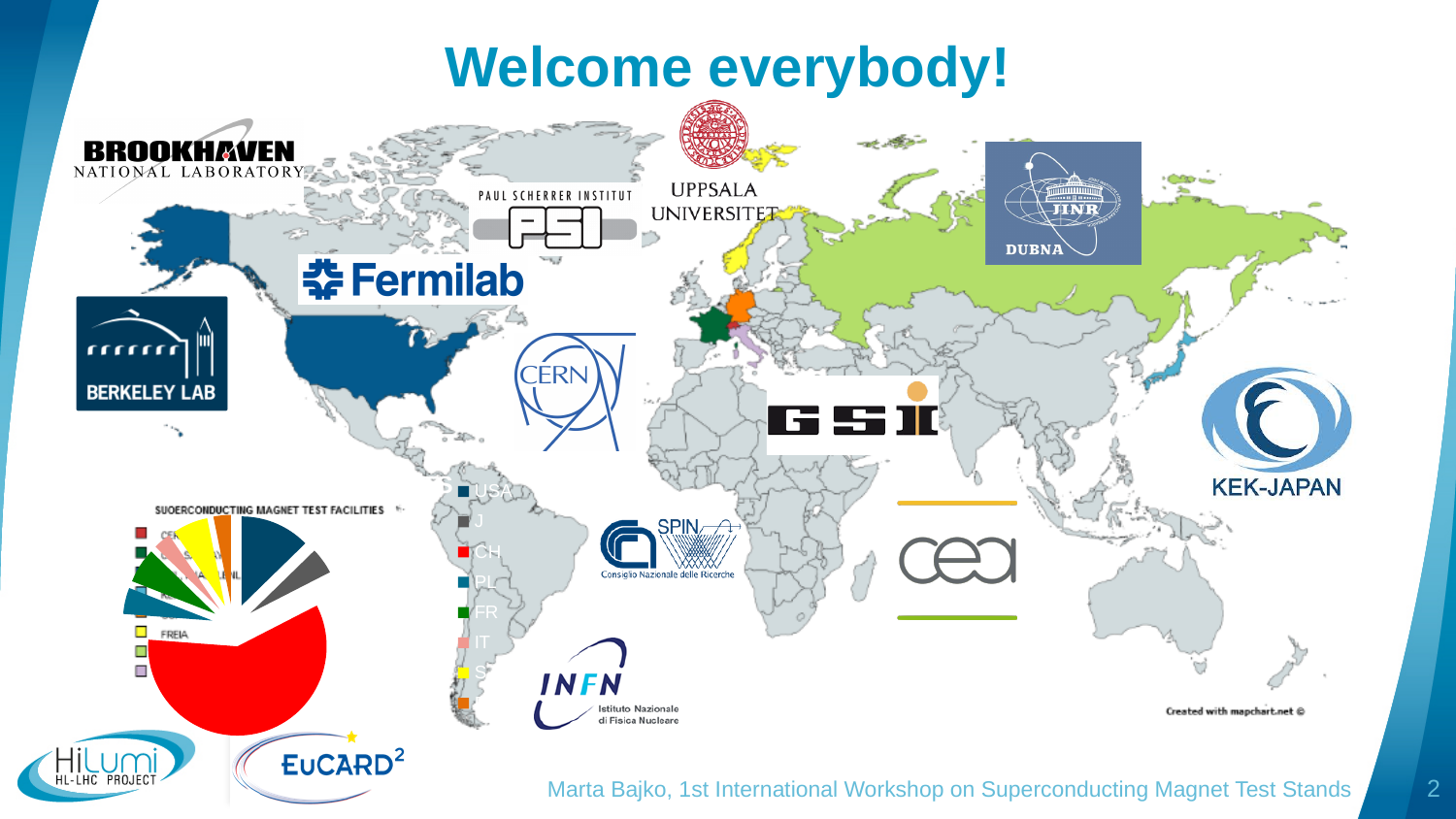
Which facility name is shown next to the yellow legend square in the pie chart's legend? FREIA Which colour slice is the largest in the pie chart in the lower-left of the slide? red What kind of chart is shown in the lower-left of the slide? pie chart